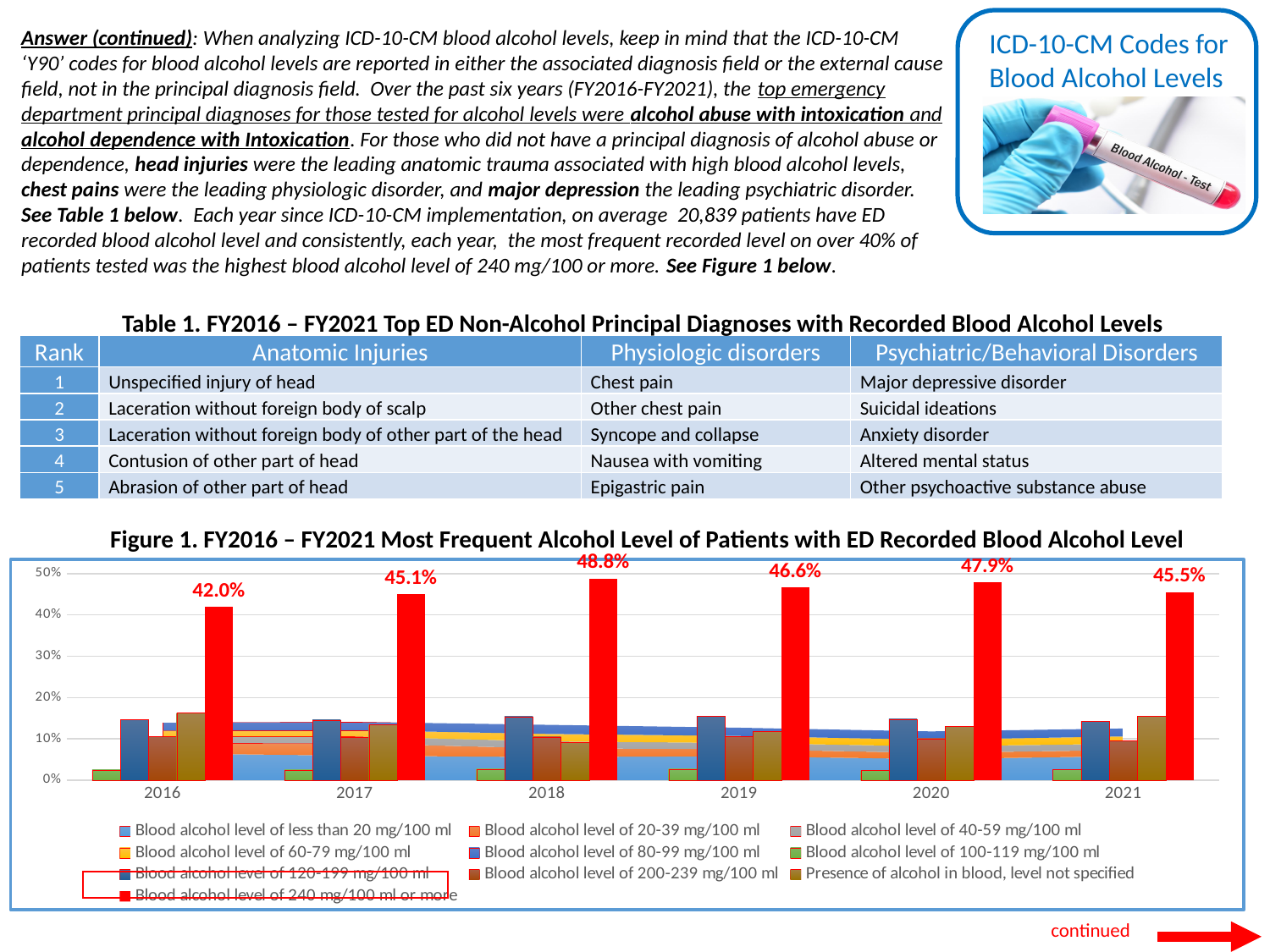
In Figure 1, what is the difference between the 2018 and 2016 values for blood alcohol level of 240 mg/100 ml or more? 6.8% In Figure 1, what is the value for blood alcohol level of 240 mg/100 ml or more in 2020? 47.9% In Figure 1, what is the value for blood alcohol level of 240 mg/100 ml or more in 2018? 48.8% In Figure 1, which year has the highest value for blood alcohol level of 240 mg/100 ml or more? 2018 In Figure 1, is the 2016 value for blood alcohol level of 120-199 mg/100 ml greater or less than 20%? less In Figure 1, does the value for blood alcohol level of 240 mg/100 ml or more rise or fall from 2016 to 2018? rise In Figure 1, which year has the larger value for blood alcohol level of 240 mg/100 ml or more, 2019 or 2021? 2019 How many years are shown on the x axis of Figure 1? 6 What kind of chart is Figure 1? combination area and bar chart In Figure 1, what is the value for blood alcohol level of 240 mg/100 ml or more in 2016? 42.0% How many series does the legend of Figure 1 list? 10 In Figure 1, which year has the lowest value for blood alcohol level of 240 mg/100 ml or more? 2016